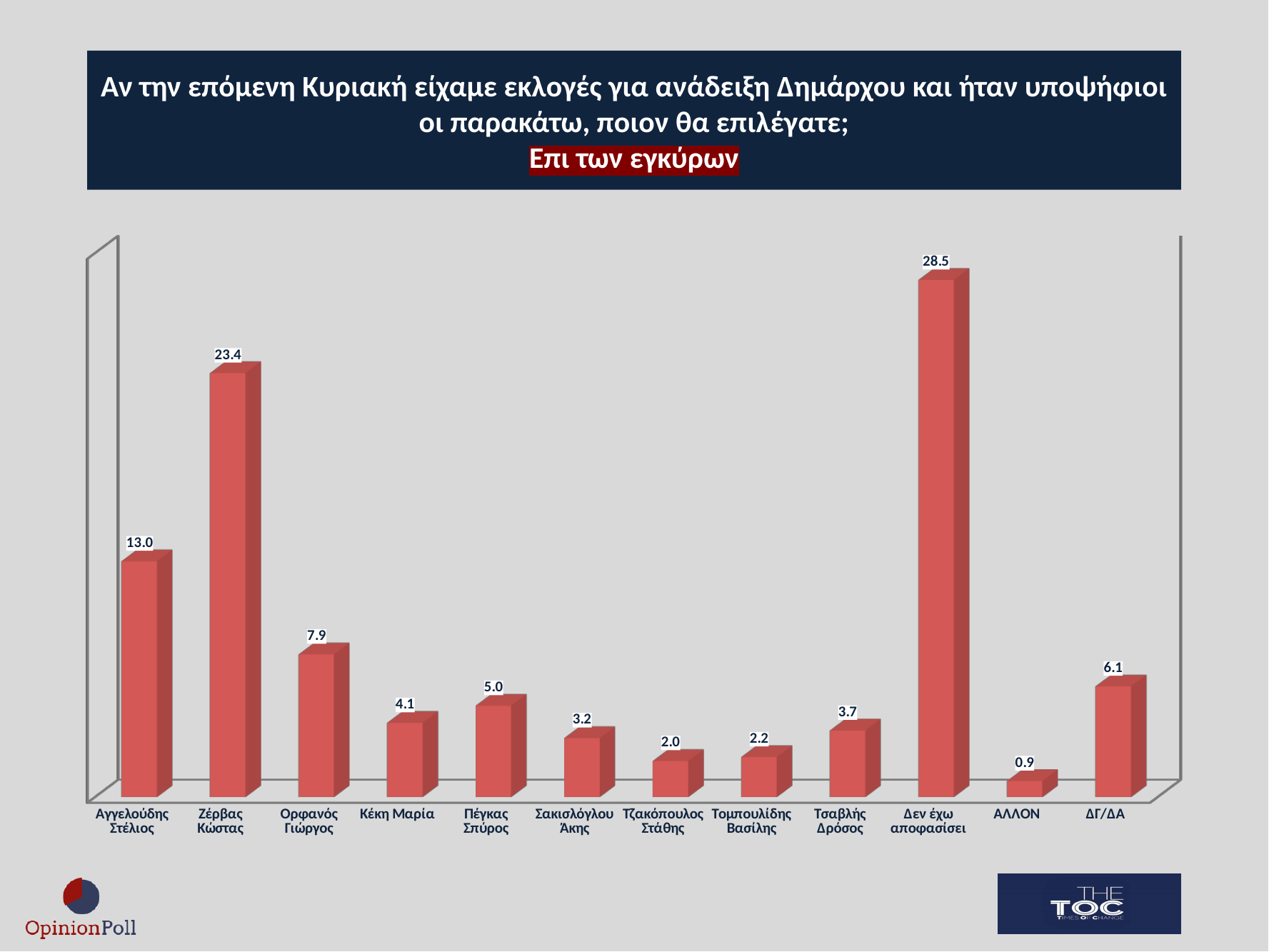
How many categories are shown on the x axis? 12 What is the difference between the values for Δεν έχω αποφασίσει and Ζέρβας Κώστας? 5.1 Which category has the lowest value? ΑΛΛΟΝ What is the difference between the values for Ζέρβας Κώστας and Αγγελούδης Στέλιος? 10.4 What is the value for ΔΓ/ΔΑ? 6.1 Which category has the highest value? Δεν έχω αποφασίσει What is the value for Αγγελούδης Στέλιος? 13.0 What is the value for Τσαβλής Δρόσος? 3.7 What is the value for Ορφανός Γιώργος? 7.9 What is the value for Ζέρβας Κώστας? 23.4 Which is larger, the value for Πέγκας Σπύρος or the value for Κέκη Μαρία? Πέγκας Σπύρος What kind of chart is shown on the slide? Bar chart